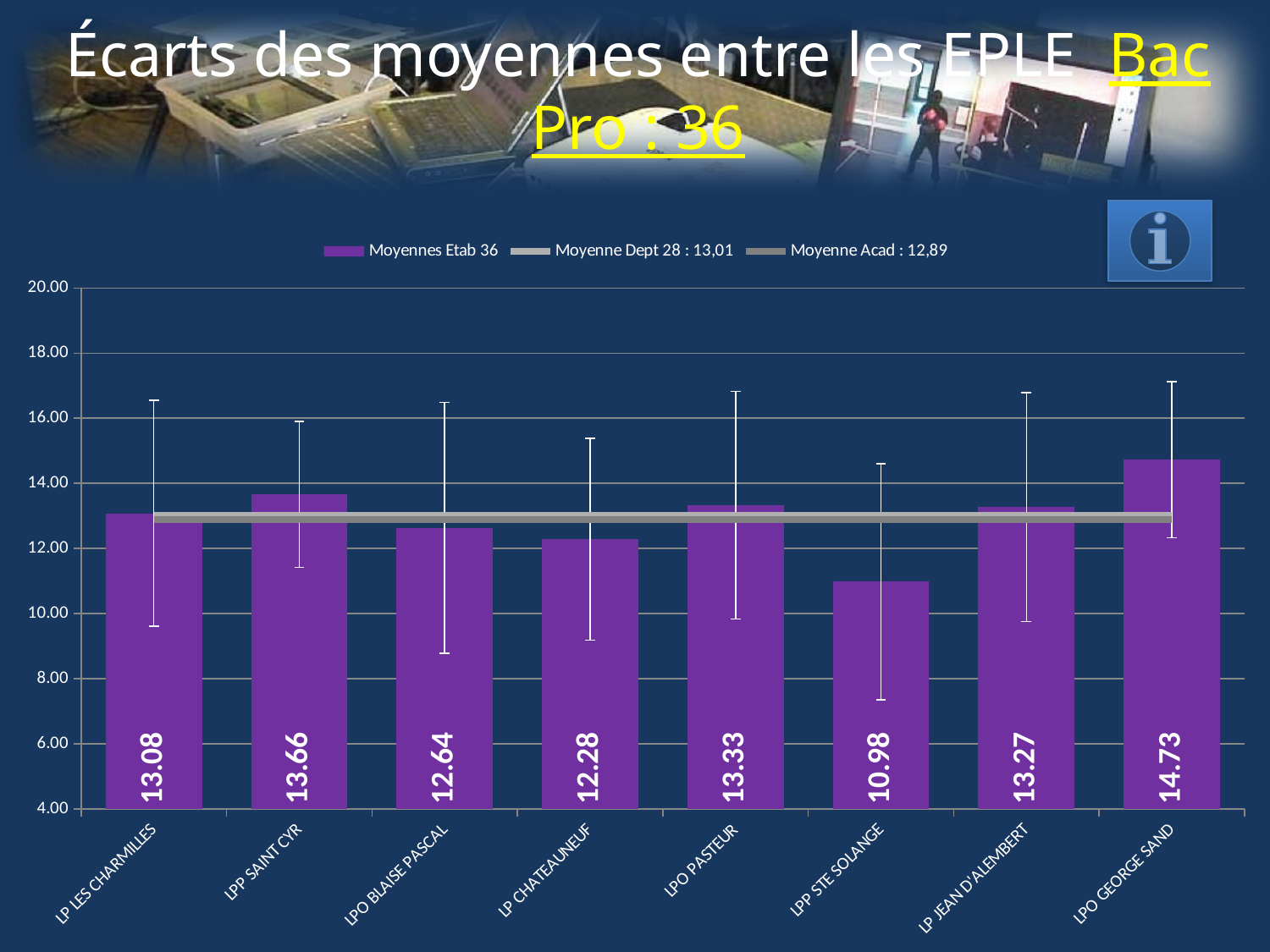
Is the value for LPO PASTEUR greater or less than 12.00? greater How many series does the legend list? 3 What is the difference between the values for LPO GEORGE SAND and LPP STE SOLANGE? 3.75 What is the value for LP CHATEAUNEUF? 12.28 What kind of chart is shown on the slide? bar chart What value does the legend give for Moyenne Dept 28? 13,01 Which is larger, the value for LP LES CHARMILLES or the value for LPO BLAISE PASCAL? LP LES CHARMILLES How many establishments are shown on the x axis? 8 Which establishment has the highest value? LPO GEORGE SAND What is the value for LPP STE SOLANGE? 10.98 What is the value for LPP SAINT CYR? 13.66 Which establishment has the lowest value? LPP STE SOLANGE